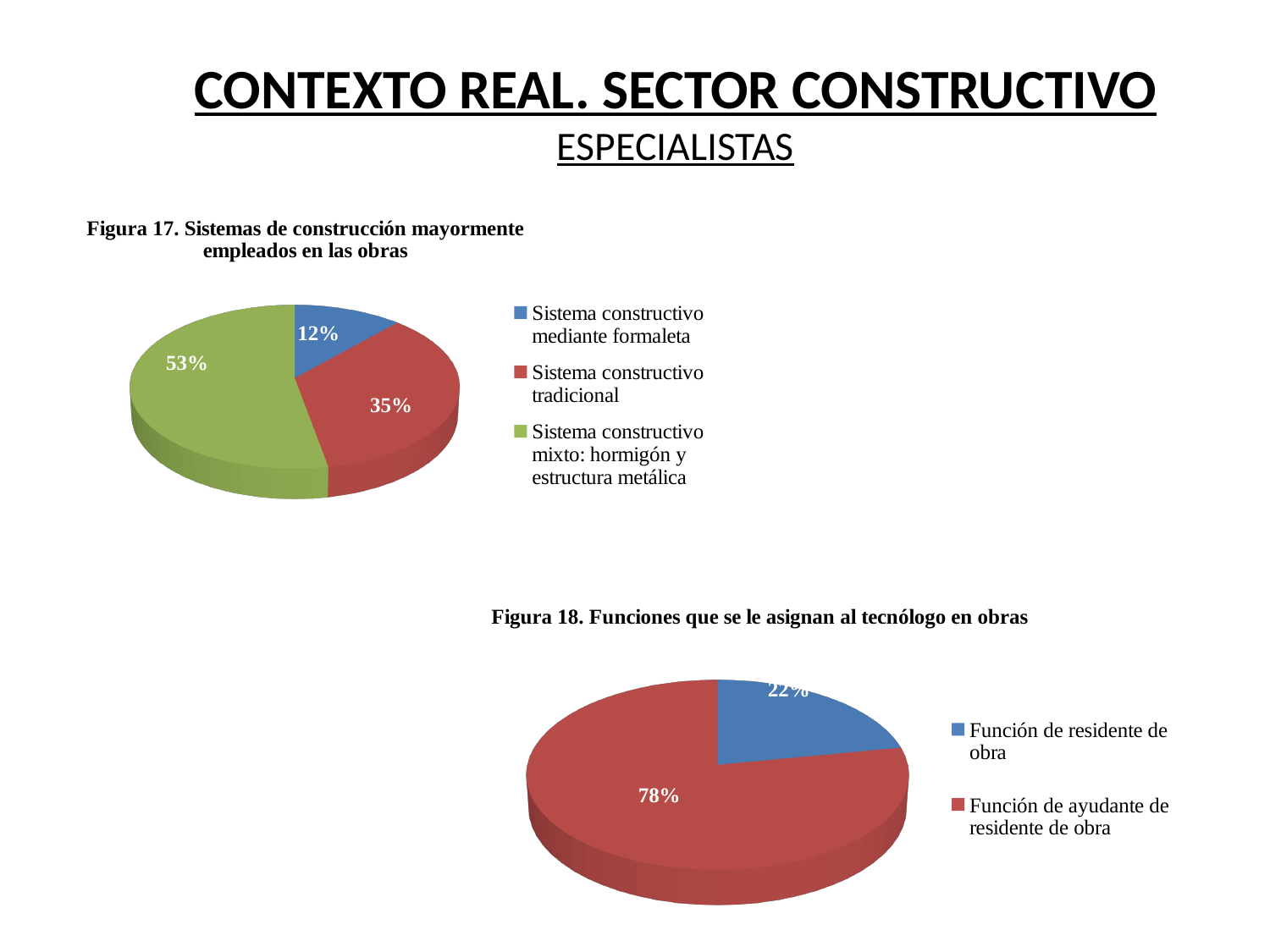
In the Figura 18 chart, what share is labelled for 'Función de residente de obra'? 22% In the Figura 17 chart, what share is labelled for 'Sistema constructivo tradicional'? 35% In the Figura 18 chart, what share is labelled for 'Función de ayudante de residente de obra'? 78% In the Figura 17 chart, which category has the largest slice? Sistema constructivo mixto: hormigón y estructura metálica In the Figura 17 chart, what share is labelled for 'Sistema constructivo mediante formaleta'? 12% In the Figura 17 chart, how many categories does the legend list? 3 In the Figura 18 chart, what is the difference in percentage points between 'Función de ayudante de residente de obra' and 'Función de residente de obra'? 56 percentage points In the Figura 17 chart, what share is labelled for 'Sistema constructivo mixto: hormigón y estructura metálica'? 53% What kind of chart is the Figura 17 chart? Pie chart In the Figura 18 chart, which is larger: 'Función de residente de obra' or 'Función de ayudante de residente de obra'? Función de ayudante de residente de obra In the Figura 17 chart, which category has the smallest slice? Sistema constructivo mediante formaleta In the Figura 17 chart, what is the difference in percentage points between 'Sistema constructivo mixto: hormigón y estructura metálica' and 'Sistema constructivo tradicional'? 18 percentage points